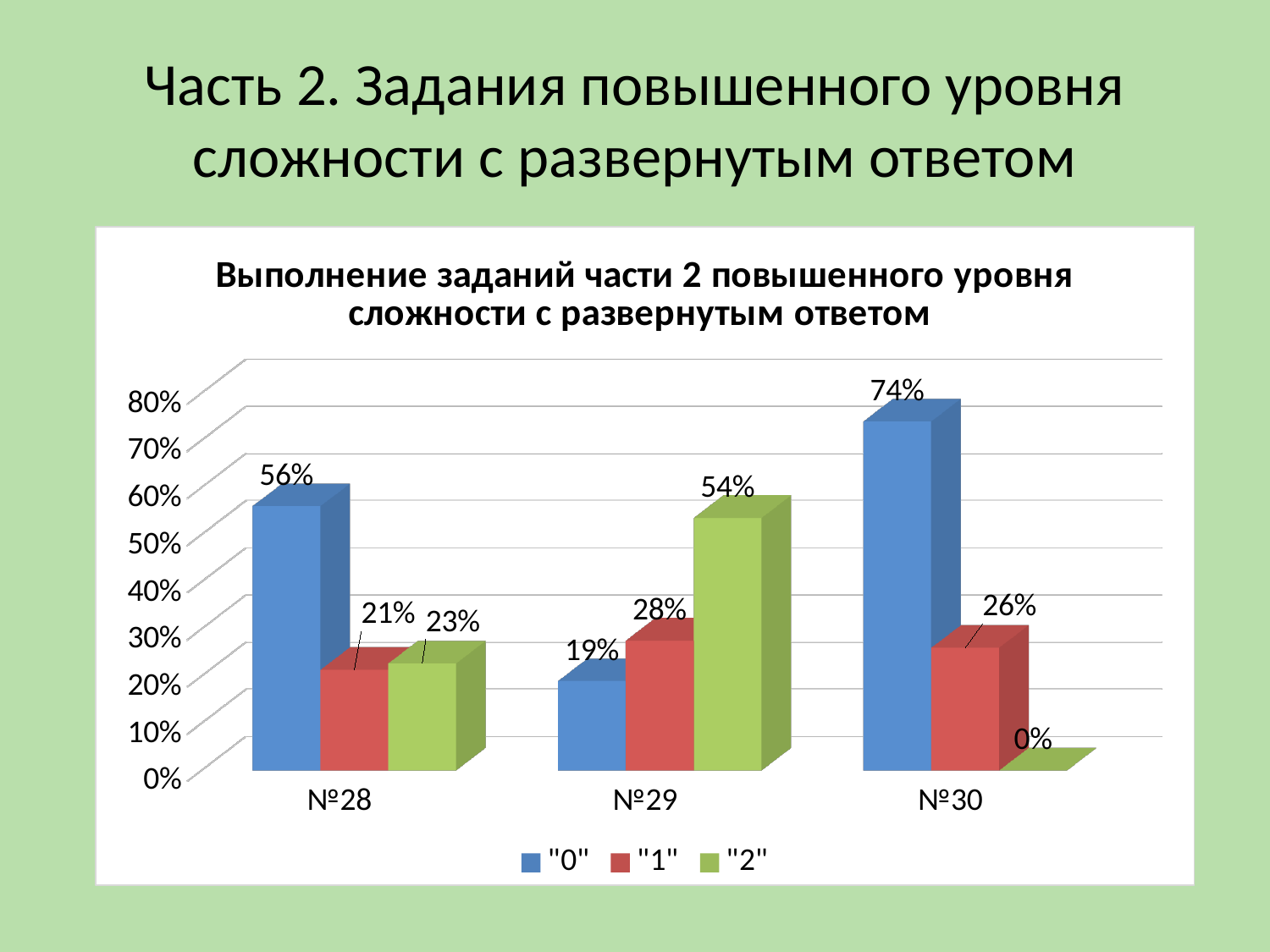
What is the value for series "0" at №28? 56% What is the value for series "2" at №29? 54% Which is larger at №29: the value for series "1" or the value for series "2"? "2" How many categories are shown on the x axis? 3 What is the value for series "2" at №30? 0% What kind of chart is this? Bar chart How many series does the legend list? 3 Which category has the lowest value for series "2"? №30 Which category has the highest value for series "0"? №30 What colour represents series "1" in the chart? Red What is the value for series "1" at №30? 26% What is the difference between the "0" value at №30 and the "0" value at №28? 18%